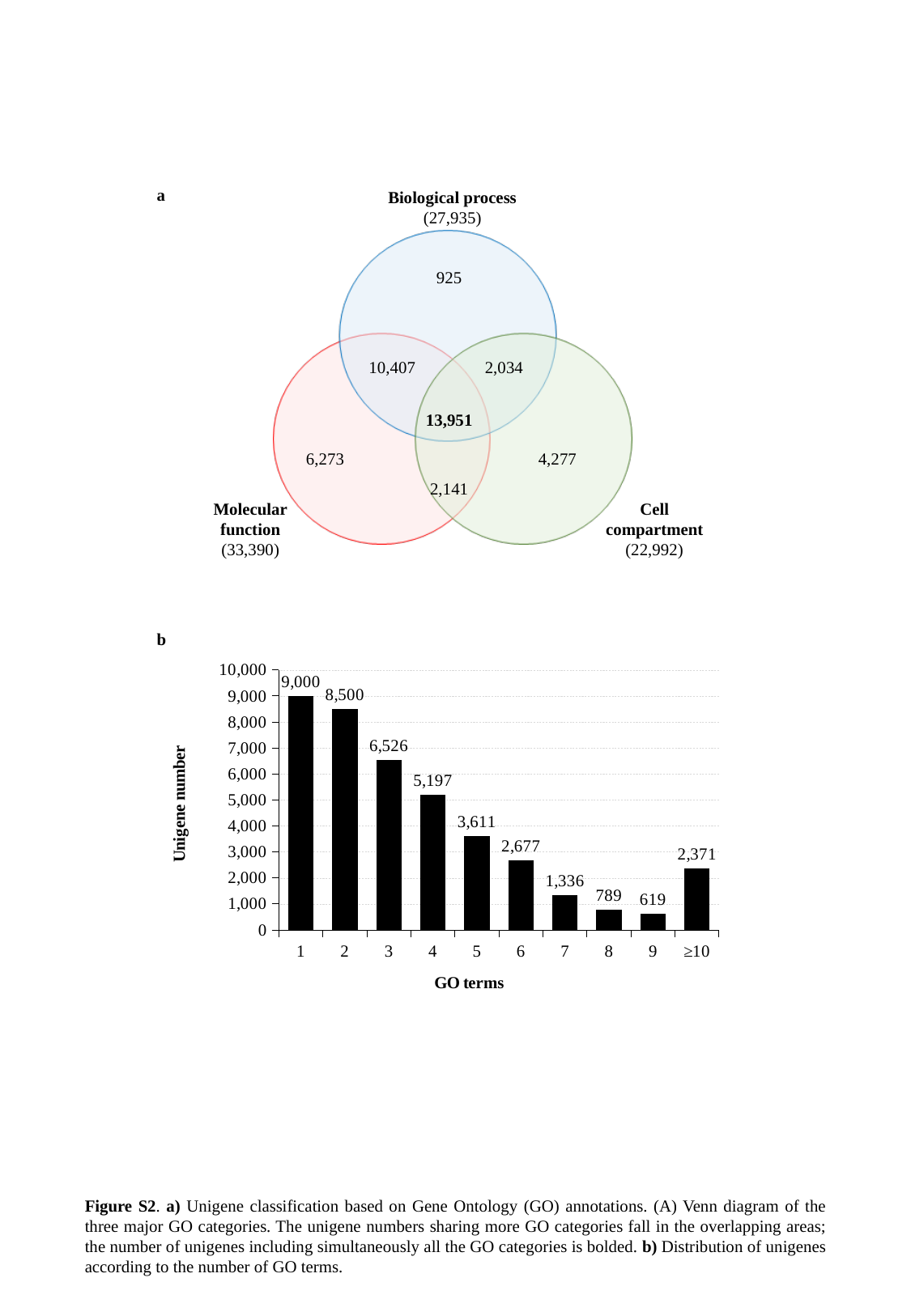
In the bar chart (panel b), which is larger: the unigene number for 8 GO terms or for ≥10 GO terms? ≥10 In the bar chart (panel b), what is the unigene number for 3 GO terms? 6,526 In the bar chart (panel b), which GO terms category has the highest unigene number? 1 In the bar chart (panel b), how many GO terms categories are shown on the x axis? 10 In the bar chart (panel b), what is the unigene number for ≥10 GO terms? 2,371 In the bar chart (panel b), which GO terms category has the lowest unigene number? 9 In the bar chart (panel b), do the unigene numbers rise or fall from 1 to 9 GO terms? fall In the bar chart (panel b), what is the difference between the unigene numbers for 1 and 2 GO terms? 500 In the Venn diagram (panel a), how many unigenes are shared by all three GO categories? 13,951 What kind of chart is panel b? bar chart In the bar chart (panel b), what is the label of the y axis? Unigene number In the Venn diagram (panel a), what is the total number of unigenes in the Molecular function category? 33,390